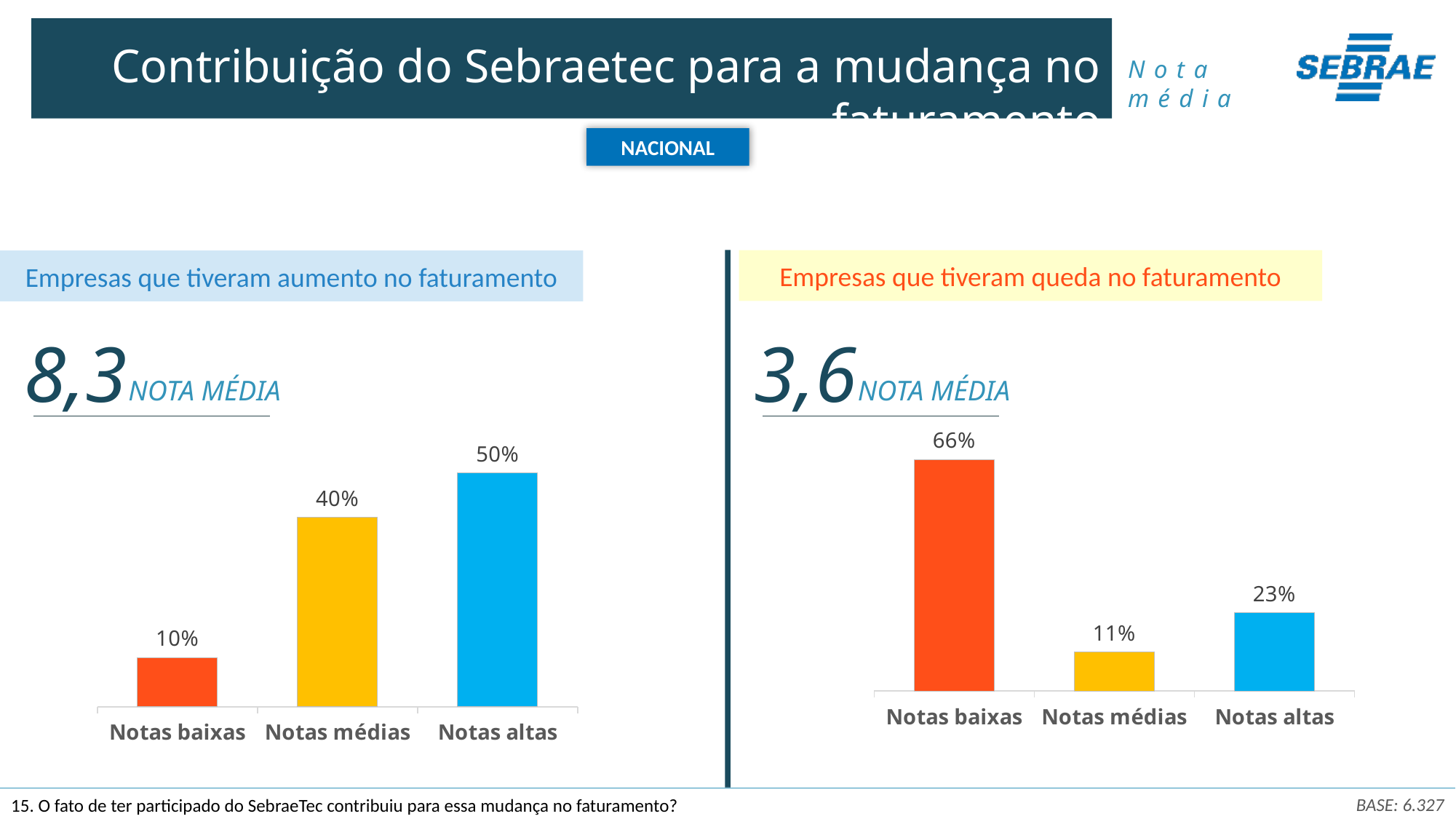
How many categories does the left chart (Empresas que tiveram aumento no faturamento) show? 3 In the right chart (Empresas que tiveram queda no faturamento), which is larger: Notas altas or Notas médias? Notas altas In the right chart (Empresas que tiveram queda no faturamento), what is the value for Notas baixas? 66% In the left chart (Empresas que tiveram aumento no faturamento), what is the difference between Notas altas and Notas baixas? 40 percentage points In the right chart (Empresas que tiveram queda no faturamento), which category has the lowest value? Notas médias In the left chart (Empresas que tiveram aumento no faturamento), do the values rise or fall from Notas baixas to Notas altas? Rise In the left chart (Empresas que tiveram aumento no faturamento), which category has the highest value? Notas altas In the left chart (Empresas que tiveram aumento no faturamento), what is the value for Notas baixas? 10% In the right chart (Empresas que tiveram queda no faturamento), what is the value for Notas médias? 11% In the left chart (Empresas que tiveram aumento no faturamento), what is the value for Notas altas? 50% What kind of chart is the right chart (Empresas que tiveram queda no faturamento)? Bar chart In the right chart (Empresas que tiveram queda no faturamento), what is the difference between Notas baixas and Notas altas? 43 percentage points